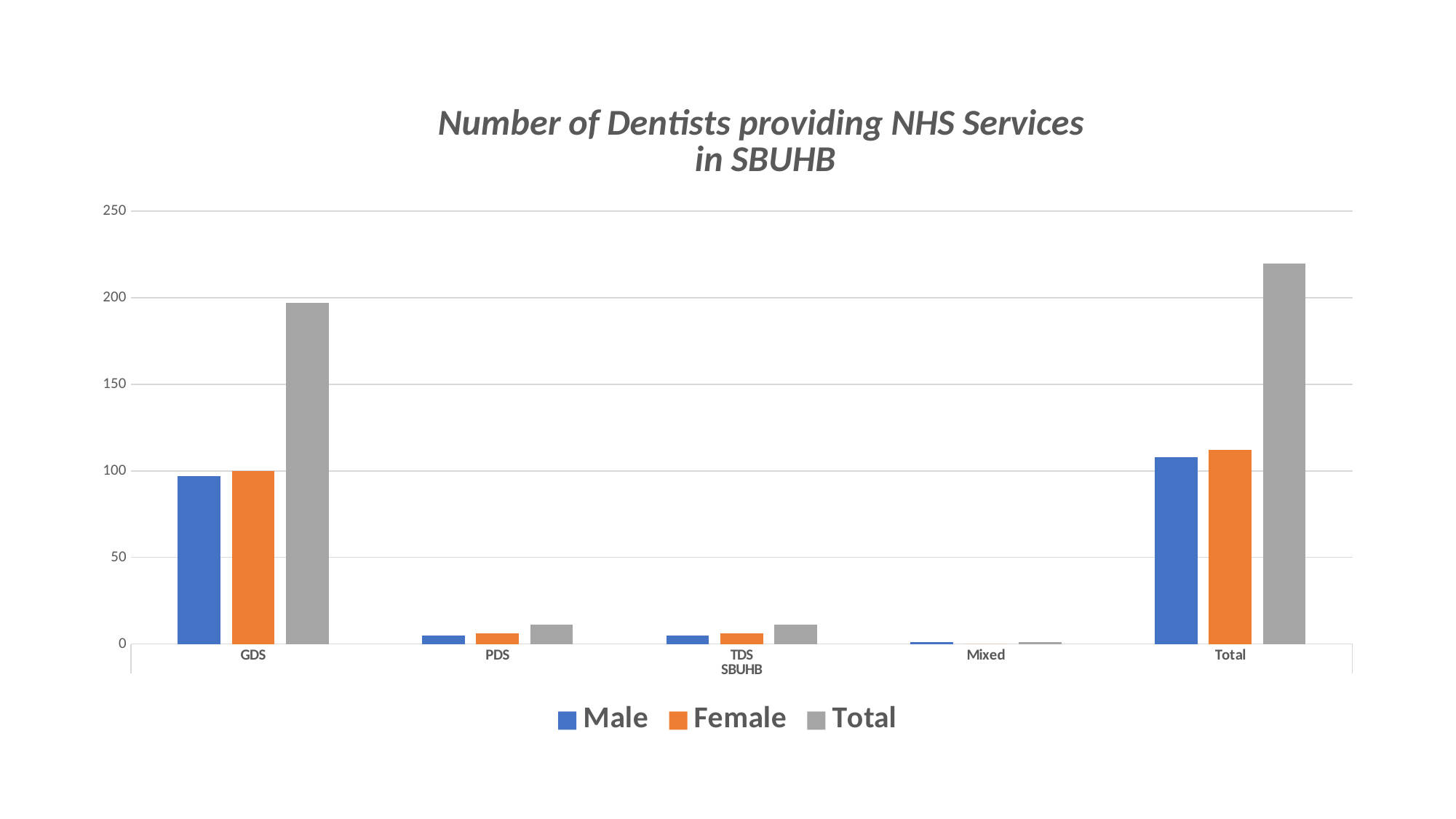
Which is larger, the Female value for GDS or the Female value for PDS? GDS What kind of chart is shown on the slide? bar chart Which category has the lowest Total series value? Mixed Is the Total series value for PDS greater or less than 50? less How many series does the legend list? 3 Which category has the highest Total series value? Total Is the Total series value for the Total category greater or less than 200? greater Is the Male value for the Total category greater or less than 50? greater How many categories are shown along the x axis? 5 What is the title of the chart? Number of Dentists providing NHS Services in SBUHB Which colour represents the Female series in the legend? orange